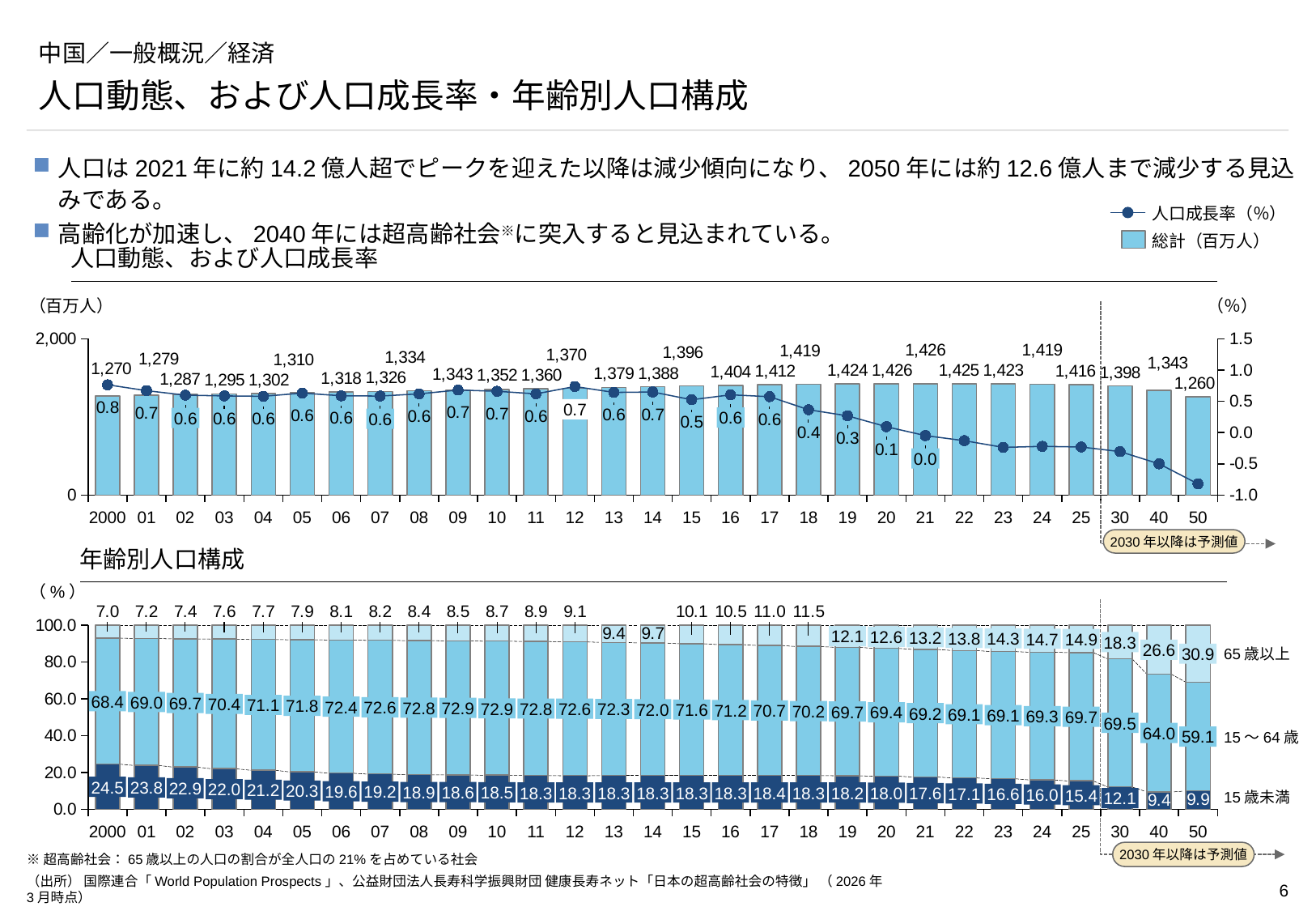
In the bottom chart (年齢別人口構成), what is the share of 15歳未満 in 2000? 24.5 In the bottom chart (年齢別人口構成), which is larger in 2040: the 65歳以上 share or the 15歳未満 share? 65歳以上 In the bottom chart (年齢別人口構成), what is the share of 65歳以上 in 2050? 30.9 In the bottom chart (年齢別人口構成), does the 65歳以上 share rise or fall from 2000 to 2050? rise In the top chart (人口動態、および人口成長率), what is the total population (百万人) shown for 2050? 1,260 In the top chart (人口動態、および人口成長率), which year has the lowest total population bar? 2050 What kind of chart is the bottom chart (年齢別人口構成)? stacked bar chart In the top chart (人口動態、および人口成長率), what is the 人口成長率 (%) value labeled for 2021? 0.0 In the top chart (人口動態、および人口成長率), what is the difference between the total population in 2025 (1,416) and in 2050 (1,260)? 156 In the top chart (人口動態、および人口成長率), how many entries does the legend list? 2 In the top chart (人口動態、および人口成長率), what is the total population (百万人) shown for 2000? 1,270 In the top chart (人口動態、および人口成長率), is the 人口成長率 value for 2050 greater or less than -0.5? less